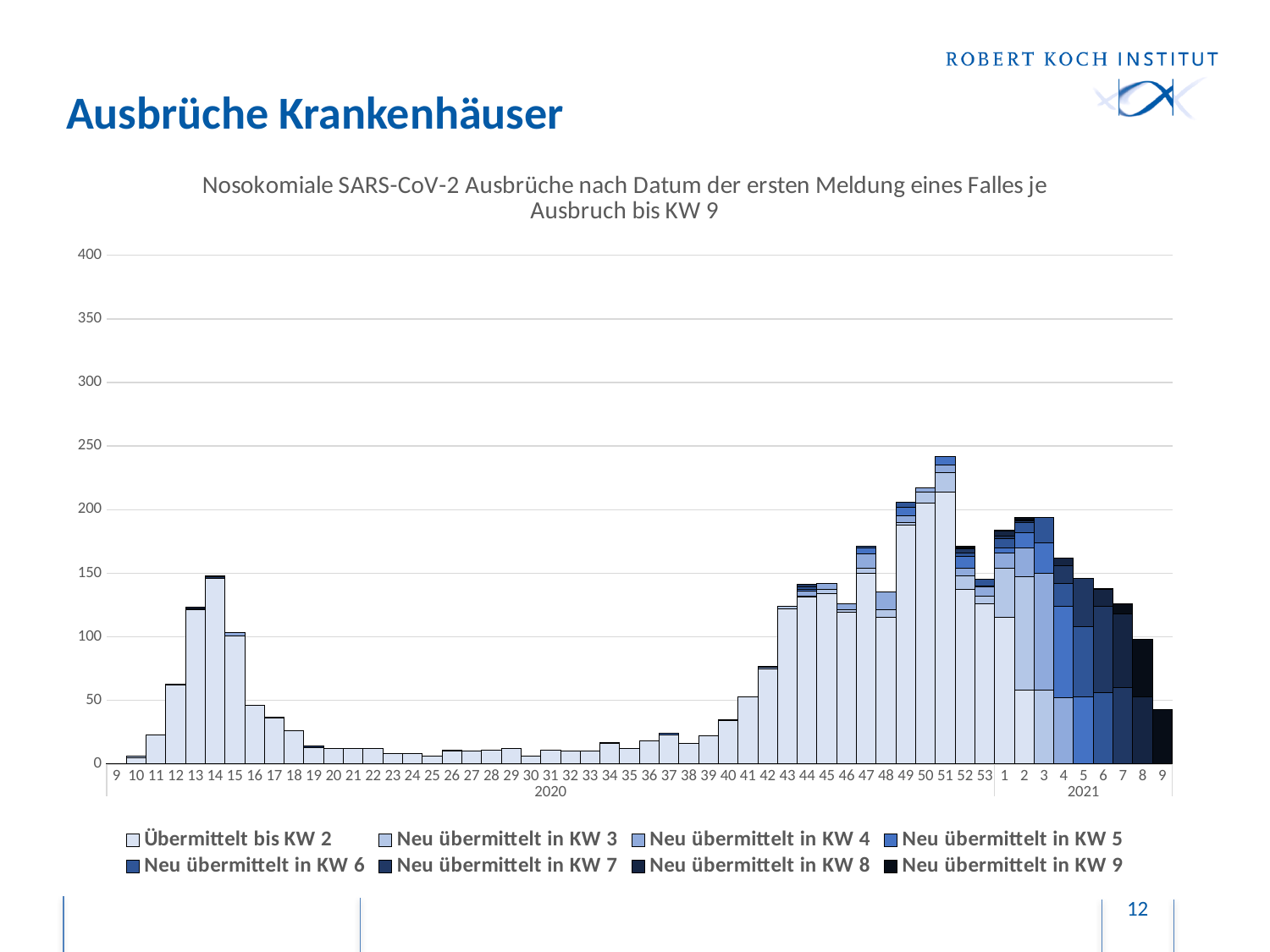
Is the total for KW 25 of 2020 greater or less than 50? less Is the total for KW 9 of 2021 greater or less than 50? less Which calendar week has the highest total number of outbreaks? KW 51 2020 How many calendar weeks (bars) are plotted on the x axis in total? 54 How many series does the legend list? 8 What kind of chart is shown on the slide? stacked bar chart What is the first series listed in the legend? Übermittelt bis KW 2 Do the totals rise or fall from KW 40 to KW 51 of 2020? rise What is the title of the chart? Nosokomiale SARS-CoV-2 Ausbrüche nach Datum der ersten Meldung eines Falles je Ausbruch bis KW 9 Is the total for KW 51 of 2020 greater or less than 200? greater Which has the larger total: KW 14 of 2020 or KW 15 of 2020? KW 14 of 2020